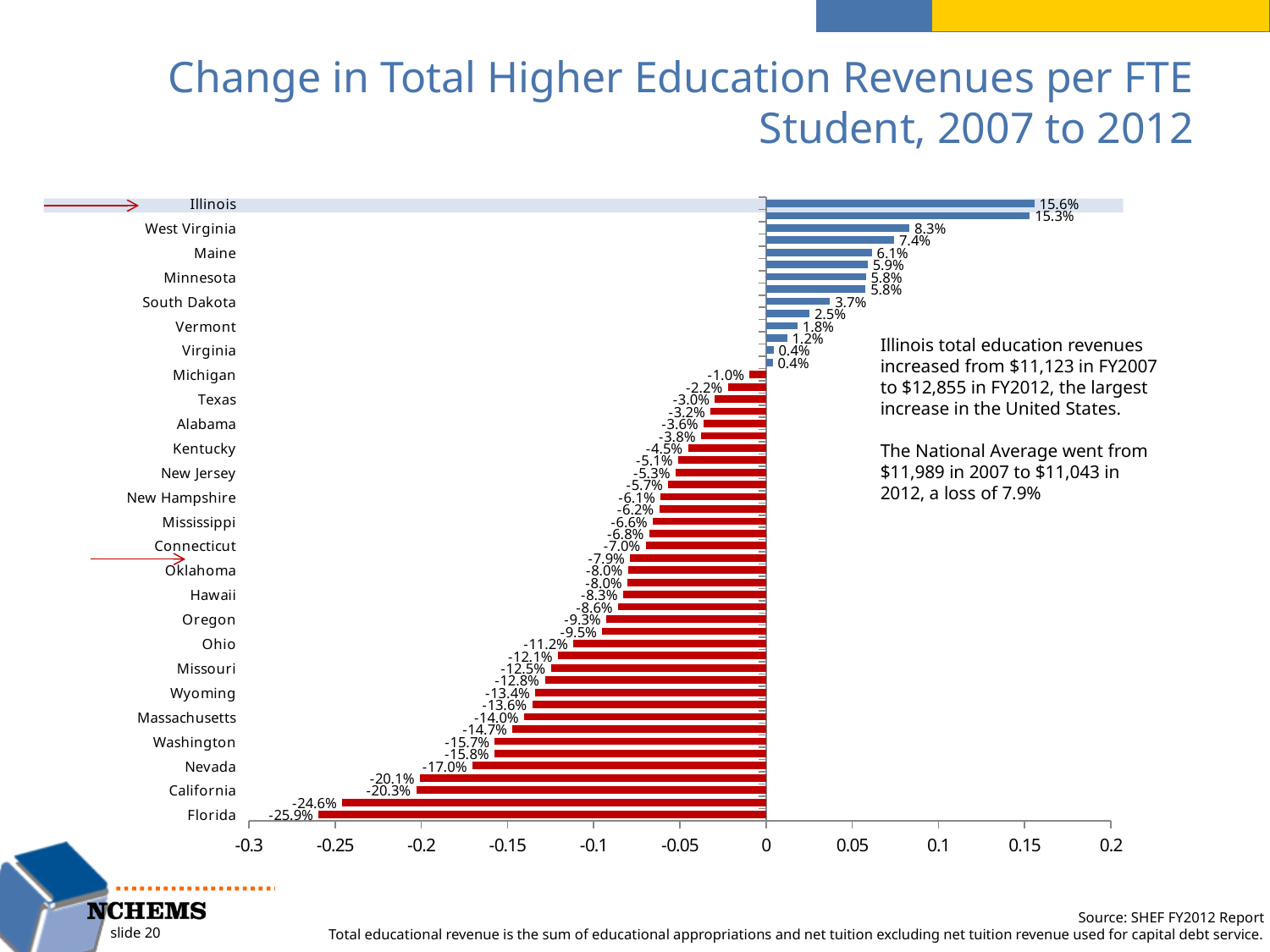
What is the value shown for Florida? -25.9% What is the title of the chart? Change in Total Higher Education Revenues per FTE Student, 2007 to 2012 Is the value for Ohio greater or less than -0.05? less Which has a larger value, Maine or South Dakota? Maine What is the value shown for West Virginia? 8.3% What is the value shown for California? -20.3% Which state has the highest change in total higher education revenues per FTE student? Illinois What kind of chart is shown on the slide? Bar chart What is the difference between the values for Illinois and West Virginia? 7.3 percentage points What is the value shown for Illinois? 15.6% What colour are the bars with negative values? Red Which state has the lowest change in total higher education revenues per FTE student? Florida